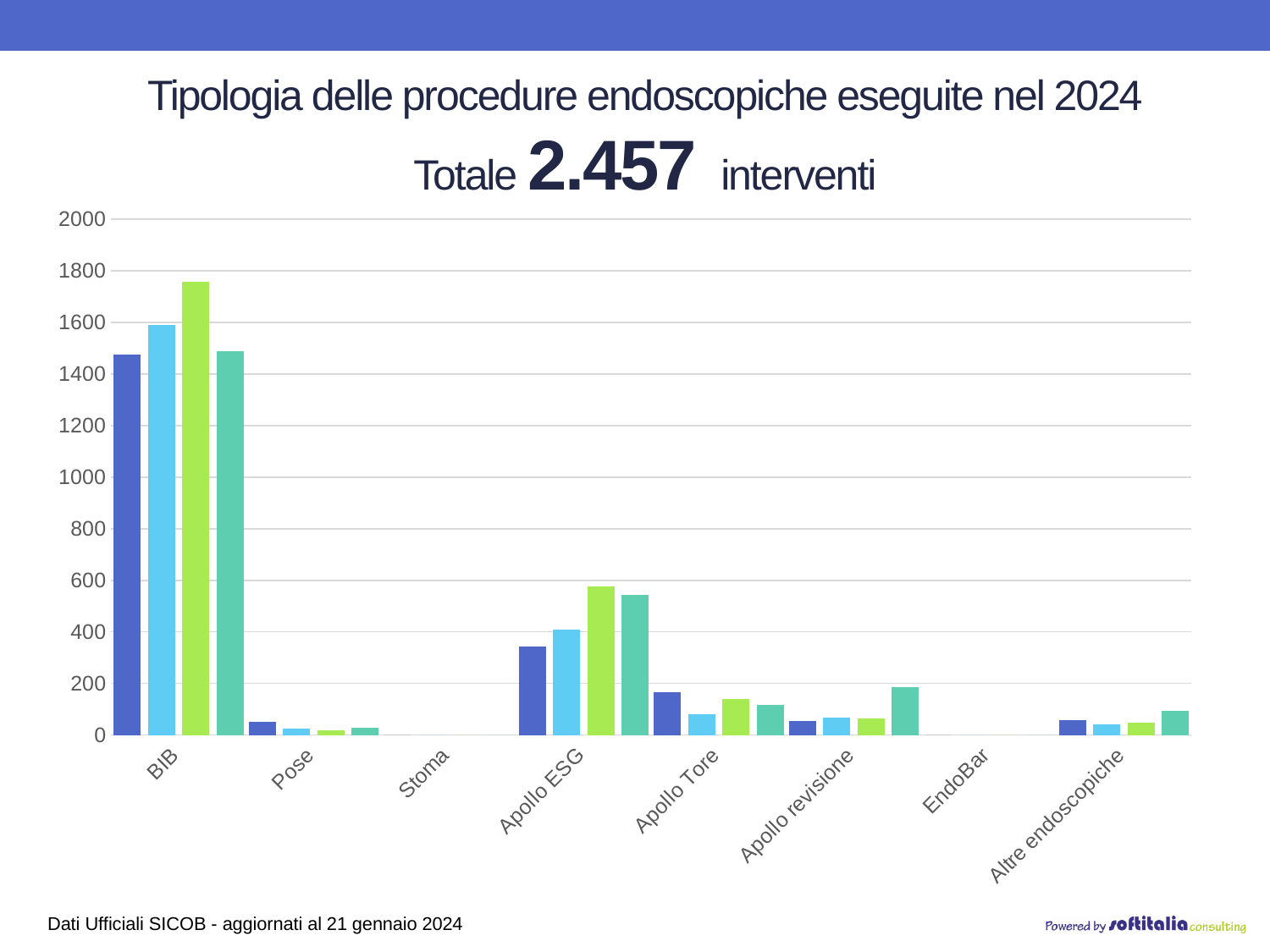
What is the title of the chart? Tipologia delle procedure endoscopiche eseguite nel 2024 Which category has larger bars, Apollo ESG or Apollo Tore? Apollo ESG Is the value of the dark blue bar for BIB greater or less than 1600? less How many categories are shown on the x axis of the chart? 8 Is the value of the dark blue bar for Apollo ESG greater or less than 200? greater Which category has the tallest bars in the chart? BIB Is the value of the dark blue bar for Apollo Tore greater or less than 200? less What kind of chart is shown on the slide? bar chart What total number of interventi is stated in the slide subtitle? 2.457 Which category has larger bars, BIB or Apollo ESG? BIB